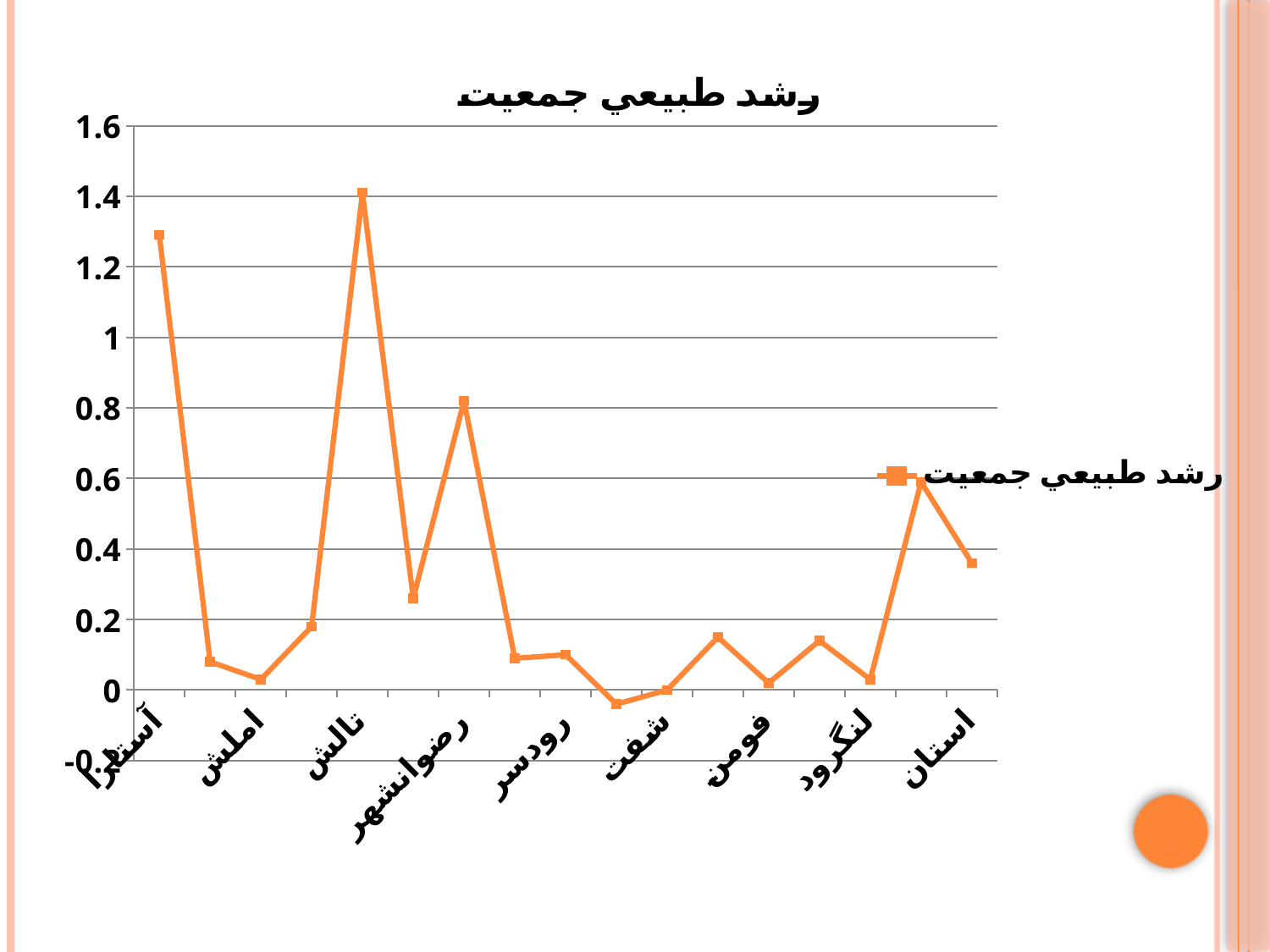
What is the title of the chart? رشد طبيعي جمعيت Which labelled category has the highest value? تالش Which is larger, the value for رضوانشهر or the value for رودسر? رضوانشهر How many data points are plotted on the line? 17 Is the value for تالش greater or less than 1.2? greater How many series does the legend list? 1 Is the value for رضوانشهر greater or less than 0.6? greater What kind of chart is shown on the slide? line chart Which is larger, the value for آستارا or the value for رضوانشهر? آستارا Is the value for املش greater or less than 0.2? less